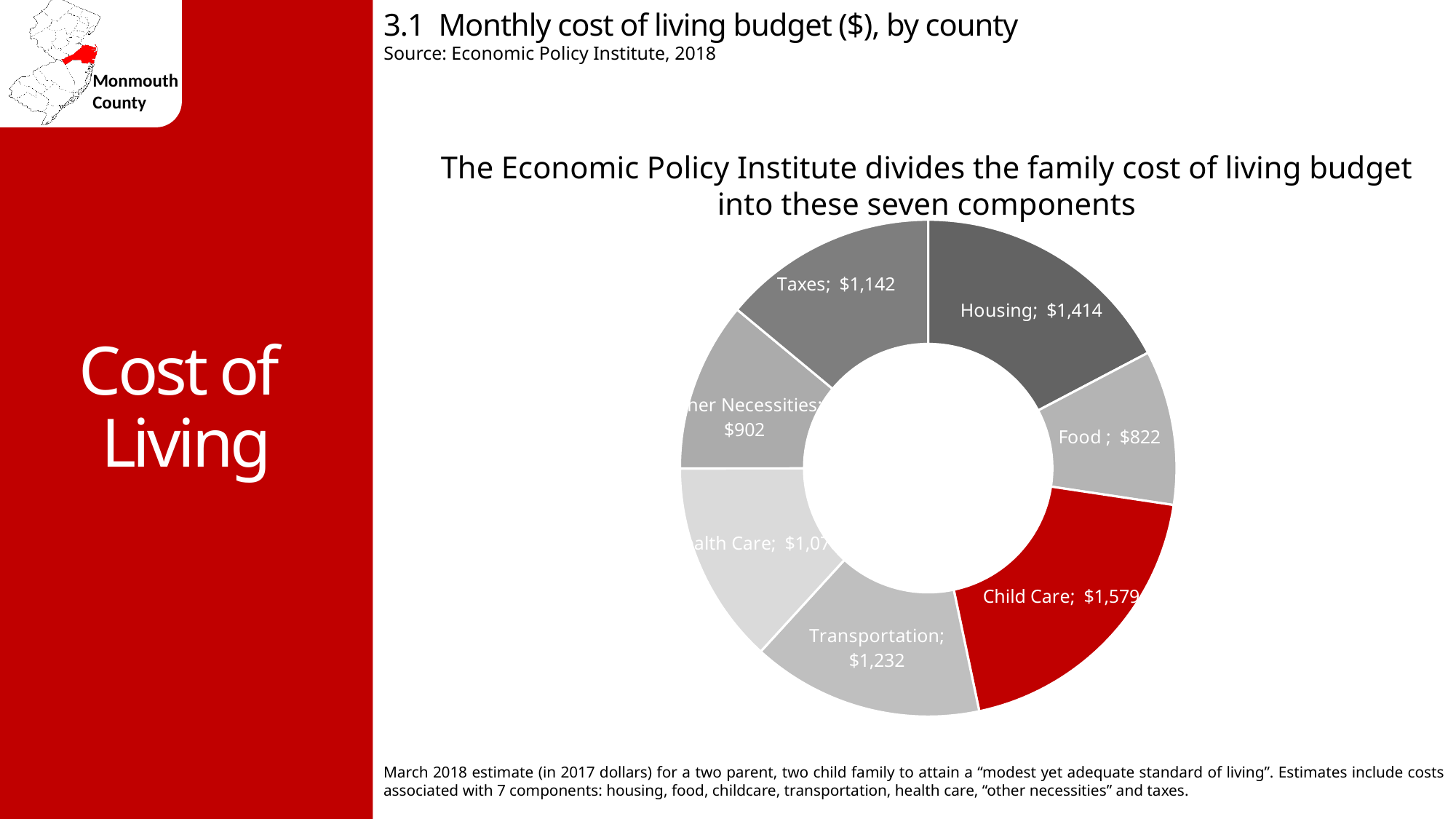
How many components are shown in the chart? 7 How much more is the monthly cost of Child Care than Housing? $165 What is the difference between the Housing and Food monthly costs? $592 What kind of chart is used on the slide? Doughnut (pie) chart What is the monthly cost for Child Care shown on the chart? $1,579 What is the monthly cost for Housing shown on the chart? $1,414 What is the monthly cost for Transportation shown on the chart? $1,232 Which component has the lowest monthly cost? Food Which is larger, the monthly cost for Taxes or for Transportation? Transportation Which component has the highest monthly cost? Child Care What is the monthly cost for Taxes shown on the chart? $1,142 What is the monthly cost for Food shown on the chart? $822